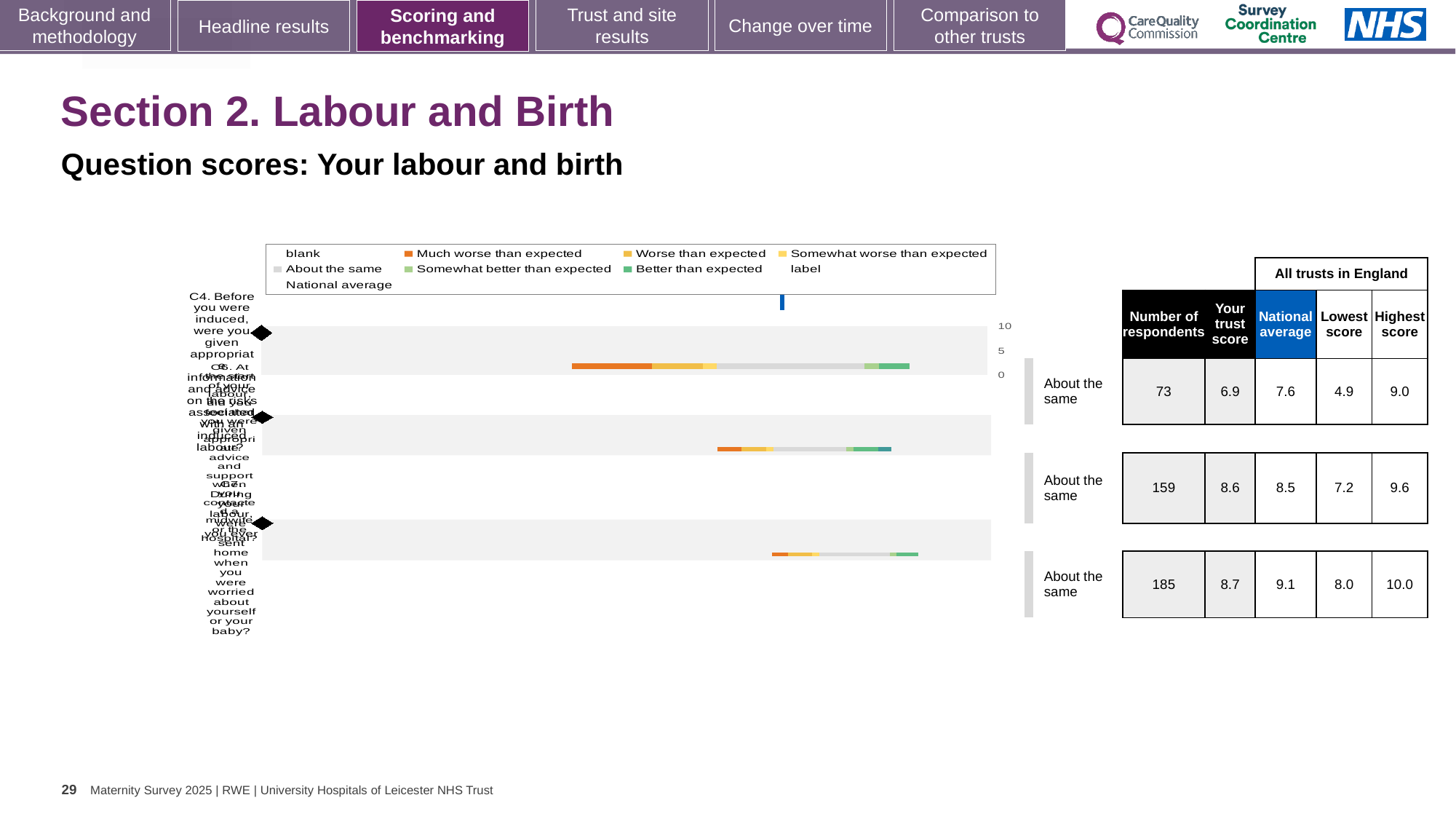
What is the national average for the third row of the chart? 9.1 How many question rows (bars) does the chart show? 3 For the first row, which is larger: 'Your trust score' or the national average? National average What kind of chart is shown on the slide? bar chart What is the difference between the national average and 'Your trust score' for the first row? 0.7 What is the number of respondents for the first row of the chart? 73 In the chart legend, what colour represents 'Better than expected'? green In the chart legend, what colour represents 'Much worse than expected'? orange What is 'Your trust score' for the second row of the chart? 8.6 Which row has the lowest 'Lowest score' among all trusts in England? the first row (4.9) Which row has the highest 'Your trust score'? the third row (8.7) What benchmark label is shown for the first row of the chart? About the same